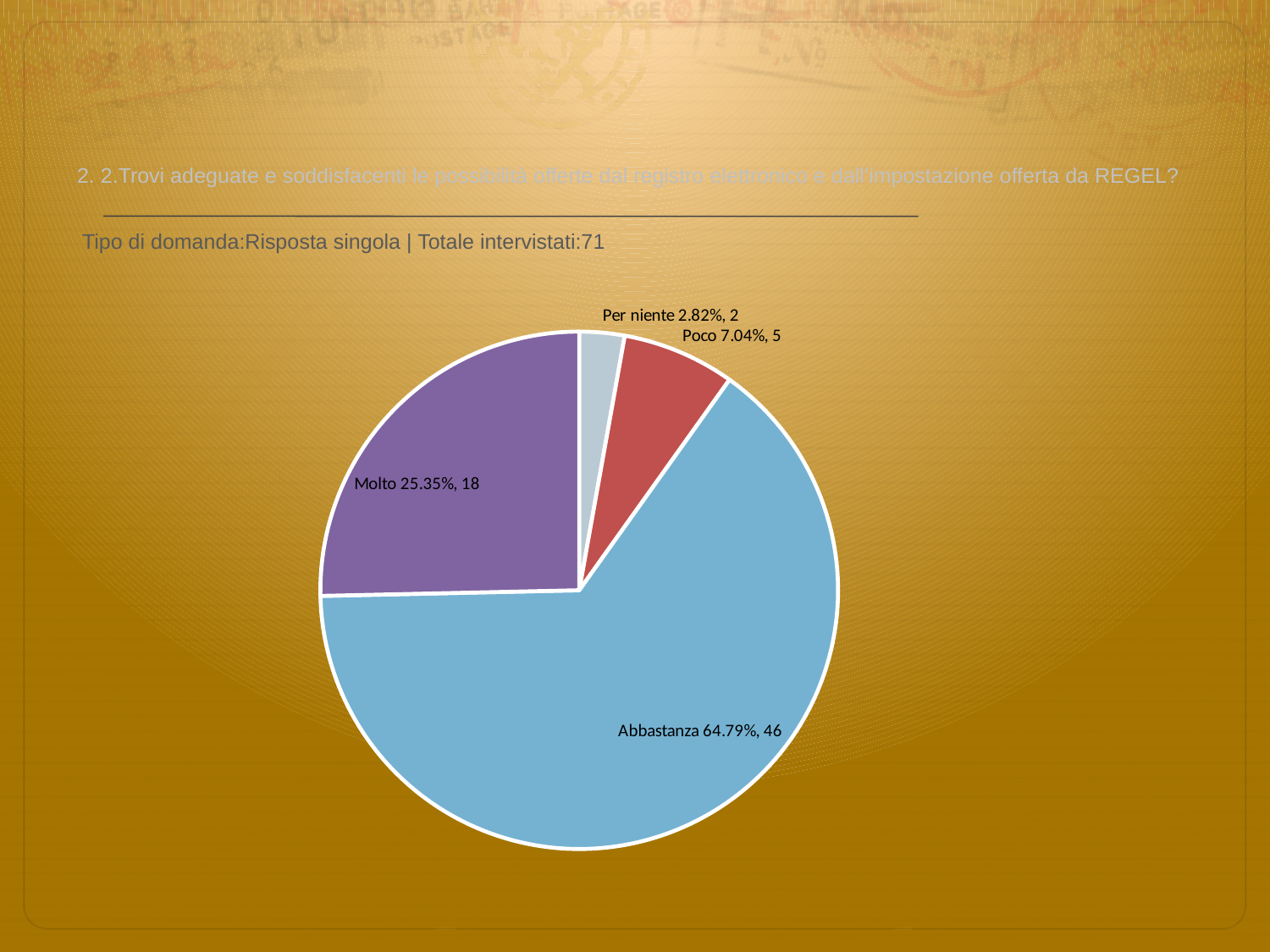
What percentage of respondents answered "Abbastanza"? 64.79% Which response category has the smallest share of the pie? Per niente How many response categories are shown in the pie chart? 4 What is the total number of respondents (Totale intervistati) stated on the slide? 71 What kind of chart is shown on the slide? Pie chart How many respondents answered "Molto"? 18 Which response category has the largest share of the pie? Abbastanza Which has more respondents, "Poco" or "Per niente"? Poco What is the difference in the number of respondents between "Abbastanza" and "Molto"? 28 How many respondents answered "Per niente"? 2 What is the share of the pie for the "Molto" slice? 25.35% What percentage of respondents answered "Poco"? 7.04%